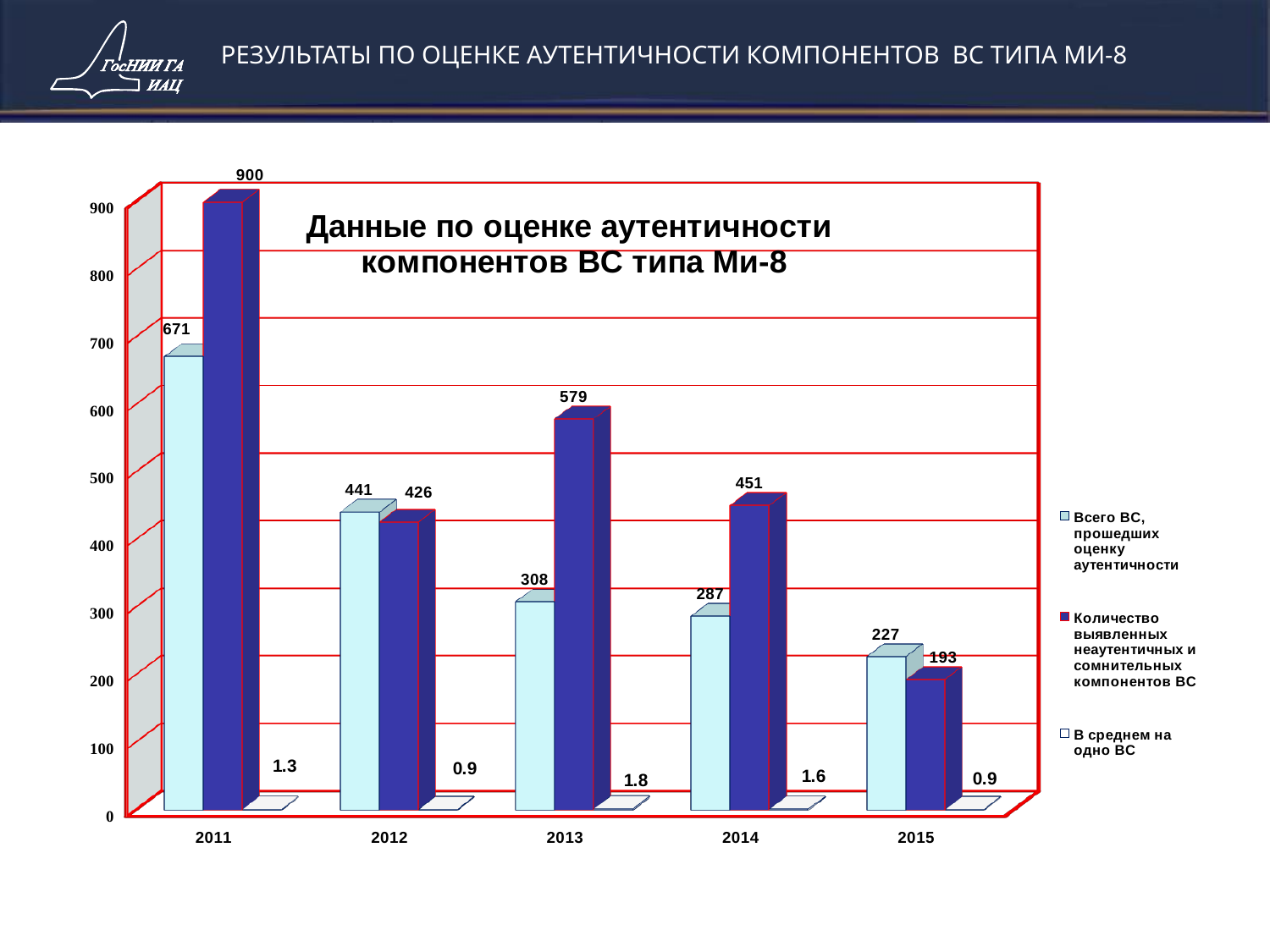
In which year is 'Всего ВС, прошедших оценку аутентичности' lowest? 2015 In 2015, which is larger: 'Всего ВС, прошедших оценку аутентичности' or 'Количество выявленных неаутентичных и сомнительных компонентов ВС'? Всего ВС, прошедших оценку аутентичности What is the value of 'Всего ВС, прошедших оценку аутентичности' for 2011? 671 How many years are shown on the x axis? 5 What is the value of 'Количество выявленных неаутентичных и сомнительных компонентов ВС' for 2013? 579 Does 'Всего ВС, прошедших оценку аутентичности' rise or fall from 2011 to 2015? Fall How many series does the legend list? 3 What is the difference between 'Количество выявленных неаутентичных и сомнительных компонентов ВС' and 'Всего ВС, прошедших оценку аутентичности' in 2011? 229 In which year is 'Количество выявленных неаутентичных и сомнительных компонентов ВС' highest? 2011 What is the title of the chart? Данные по оценке аутентичности компонентов ВС типа Ми-8 What is the value of 'В среднем на одно ВС' for 2014? 1.6 What type of chart is shown on the slide? Bar chart